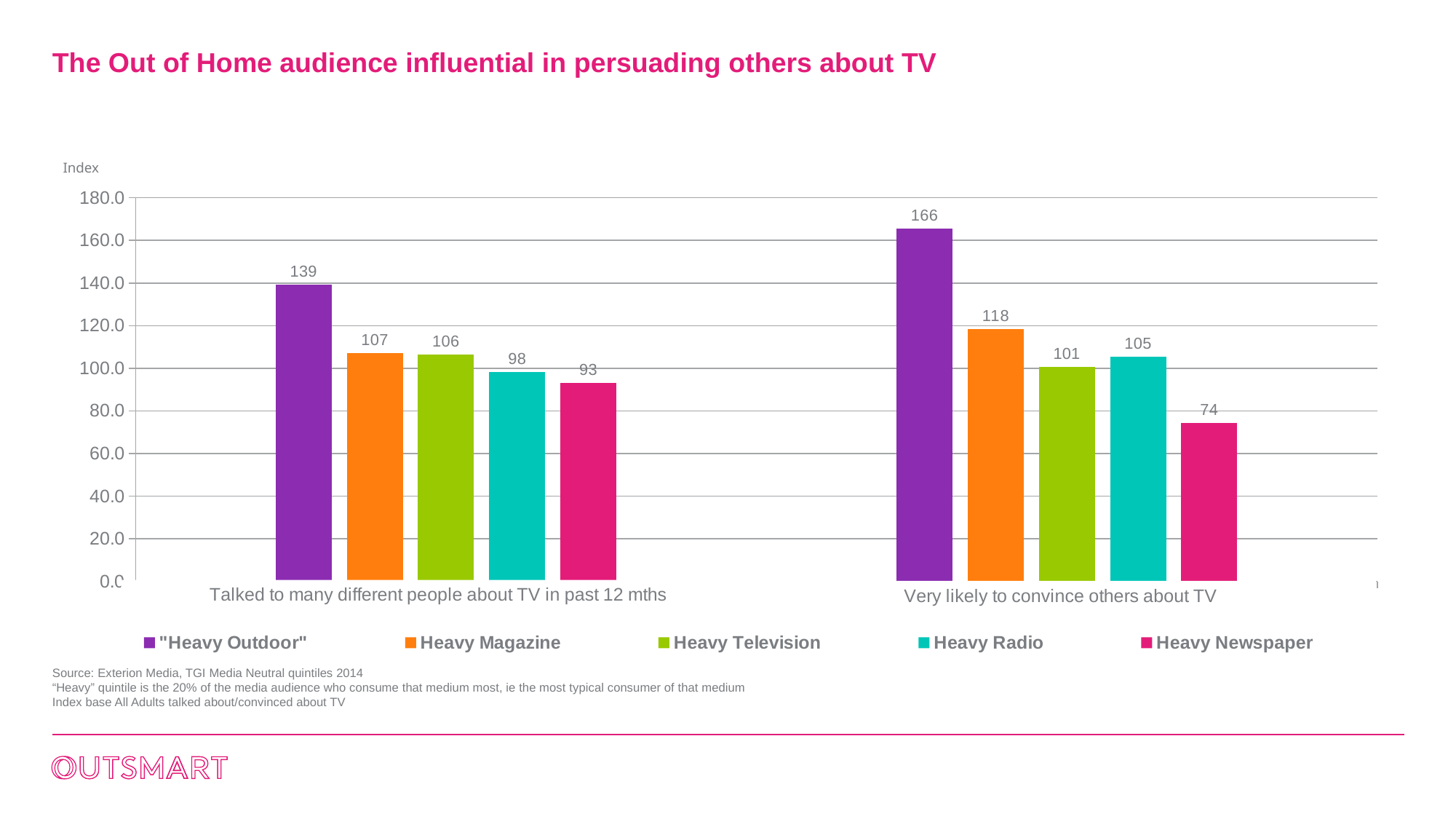
What is the difference between the "Heavy Outdoor" and Heavy Magazine values in the "Very likely to convince others about TV" category? 48 How many categories are shown on the x axis? 2 How many series does the legend list? 5 Is the value for Heavy Newspaper in the "Very likely to convince others about TV" category greater or less than 80.0? less Which is larger: Heavy Magazine or Heavy Radio in the "Talked to many different people about TV in past 12 mths" category? Heavy Magazine What is the index value for Heavy Newspaper in the "Talked to many different people about TV in past 12 mths" category? 93 Which series has the highest value in the "Talked to many different people about TV in past 12 mths" category? "Heavy Outdoor" What kind of chart is shown on the slide? Bar chart What is the label on the vertical axis of the chart? Index What is the index value for "Heavy Outdoor" in the "Very likely to convince others about TV" category? 166 What is the index value for Heavy Radio in the "Very likely to convince others about TV" category? 105 Which series has the lowest value in the "Very likely to convince others about TV" category? Heavy Newspaper